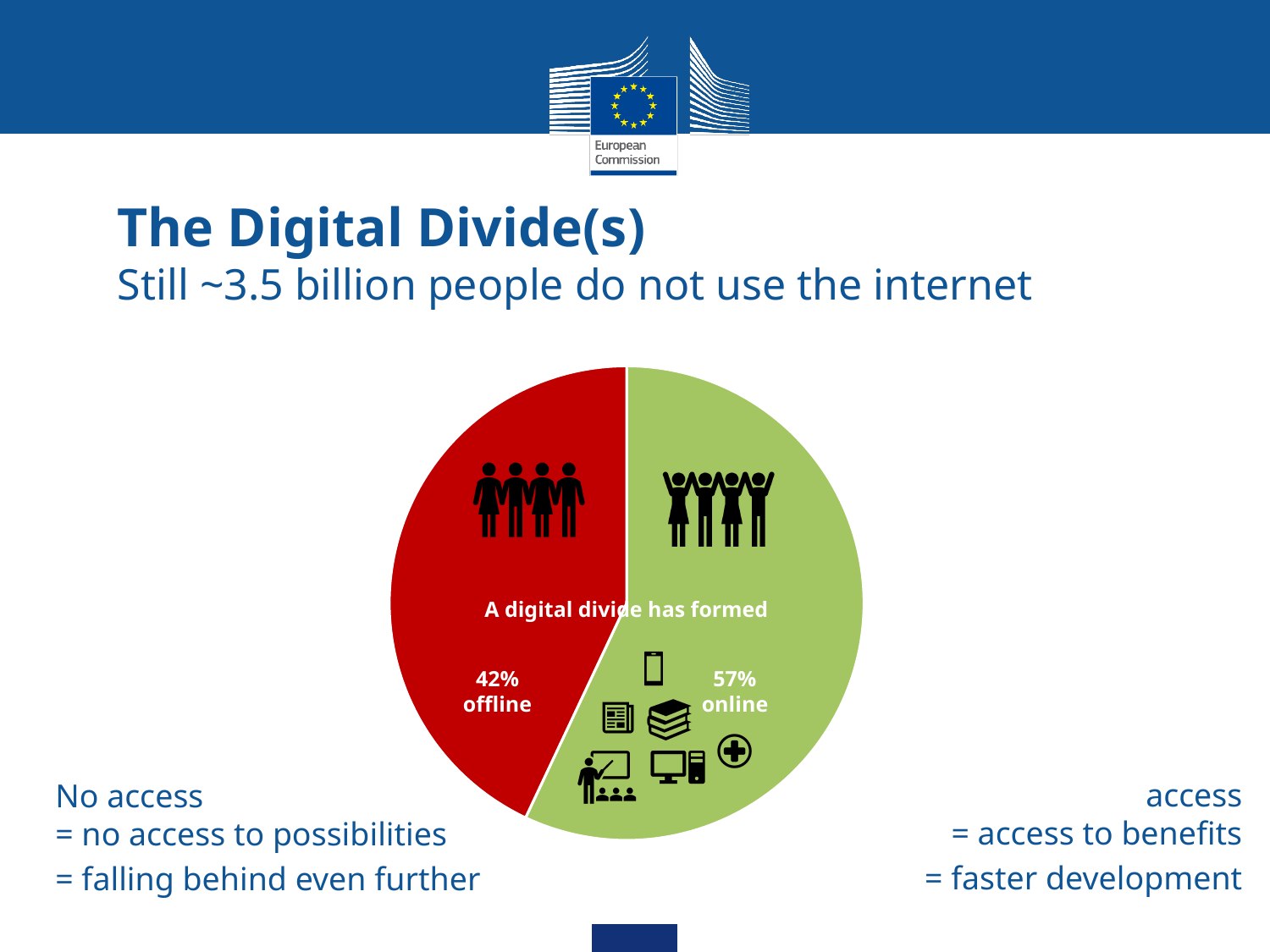
What kind of chart is shown on the slide? pie chart What is the difference in percentage points between the online and offline slices? 15 How many slices does the pie chart have? 2 Which slice of the pie chart is the smallest? offline What percentage of people are shown as offline in the pie chart? 42% Which slice of the pie chart is the largest? online What colour is the offline slice of the pie chart? red What percentage of people are shown as online in the pie chart? 57% Is the offline share in the pie chart greater or less than 50%? less What colour is the online slice of the pie chart? green Which slice of the pie chart is larger, offline or online? online